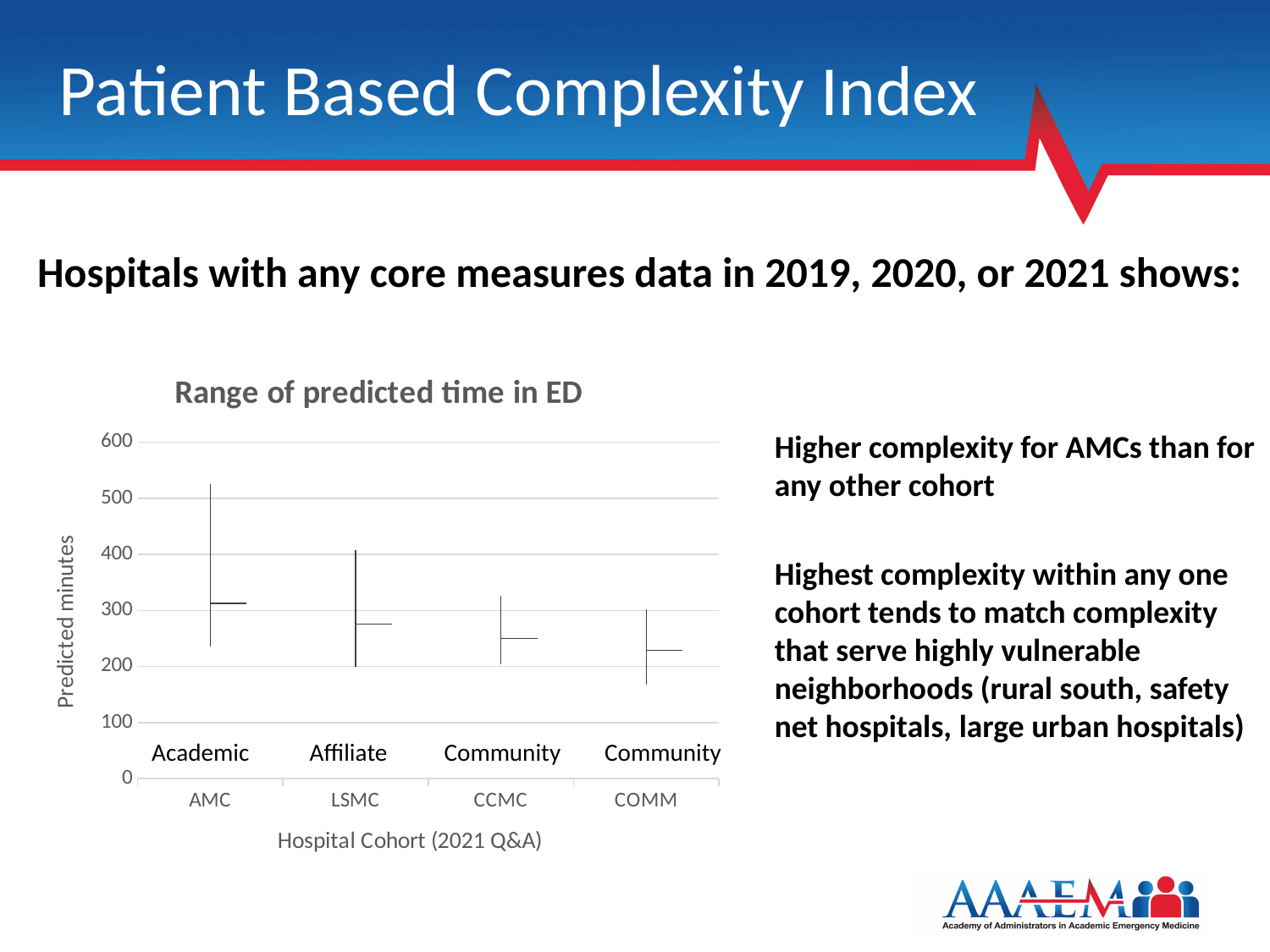
How many hospital cohorts are plotted on the x axis? 4 Which cohort has a higher upper end of its range, LSMC or COMM? LSMC What is the title of the chart? Range of predicted time in ED Which cohort has the highest upper end of its predicted time range? AMC Is the upper end of the range for LSMC greater or less than 500? less Which cohort has the lowest lower end of its predicted time range? COMM Is the upper end of the range for CCMC greater or less than 400? less Is the upper end of the range for AMC greater or less than 500? greater Do the upper ends of the ranges rise or fall moving from AMC to COMM along the x axis? fall What is the label of the vertical axis? Predicted minutes